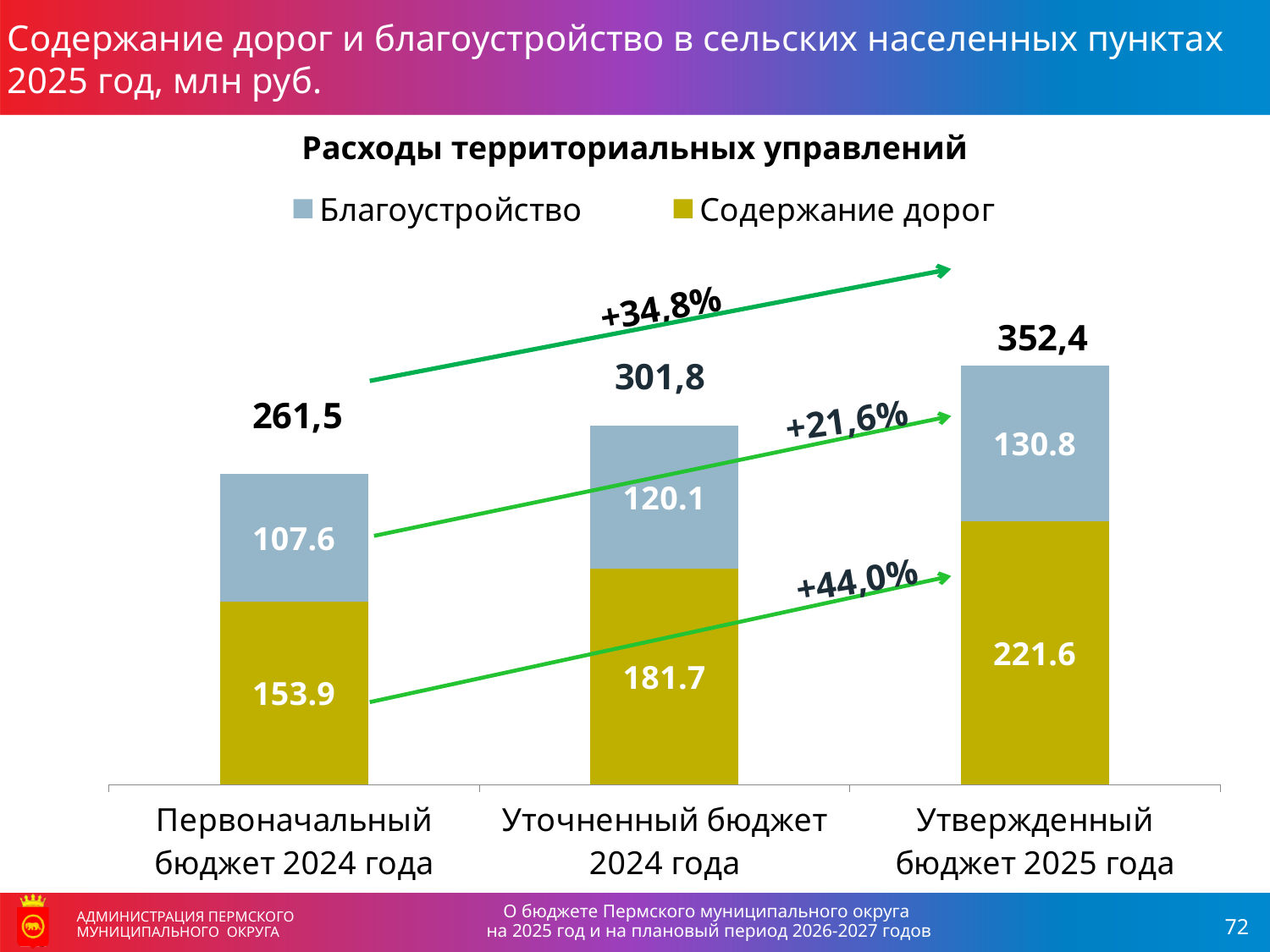
What is the total of the stacked bar for Уточненный бюджет 2024 года? 301,8 What is the difference between Содержание дорог for Утвержденный бюджет 2025 года and Уточненный бюджет 2024 года? 39.9 How many categories are shown on the x axis? 3 What is the value of Благоустройство for Утвержденный бюджет 2025 года? 130.8 What type of chart is shown on the slide? bar chart What is the total of the stacked bar for Утвержденный бюджет 2025 года? 352,4 What is the value of Содержание дорог for Первоначальный бюджет 2024 года? 153.9 Which category has the highest value for Содержание дорог? Утвержденный бюджет 2025 года What is the value of Благоустройство for Уточненный бюджет 2024 года? 120.1 Do the total values rise or fall from left to right along the x axis? rise Which category has the lowest value for Благоустройство? Первоначальный бюджет 2024 года How many series does the legend list? 2